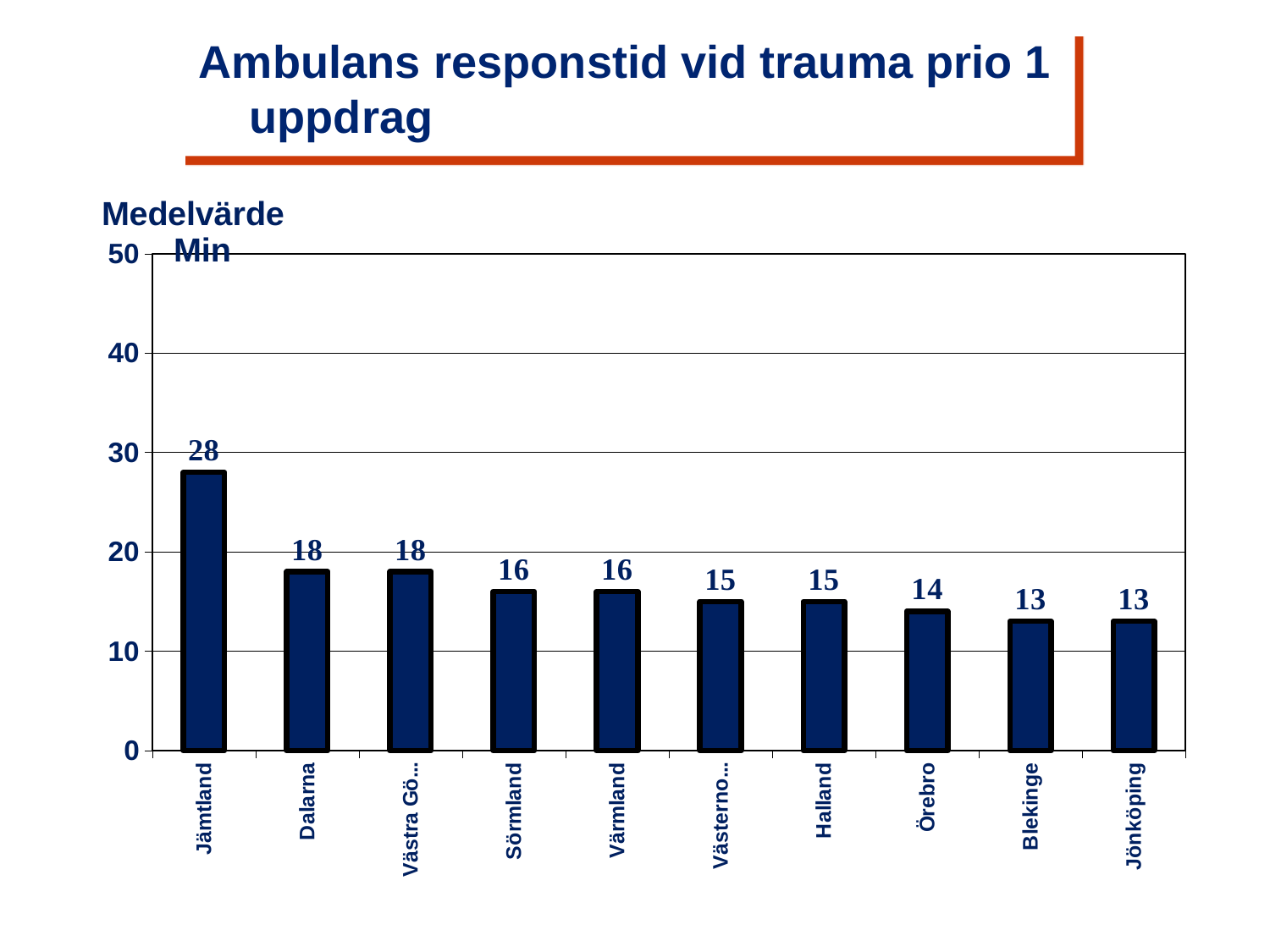
Which is larger, the value for Värmland or the value for Jönköping? Värmland What is the value for Dalarna? 18 What is the value for Halland? 15 Do the values rise or fall from left to right along the x axis? fall What kind of chart is shown on the slide? bar chart What is the value for Örebro? 14 Is the value for Jämtland greater or less than 20? greater What is the value for Jämtland? 28 Which category has the highest value? Jämtland What is the difference between the values for Jämtland and Dalarna? 10 How many categories are shown on the x axis? 10 What is the difference between the values for Sörmland and Blekinge? 3